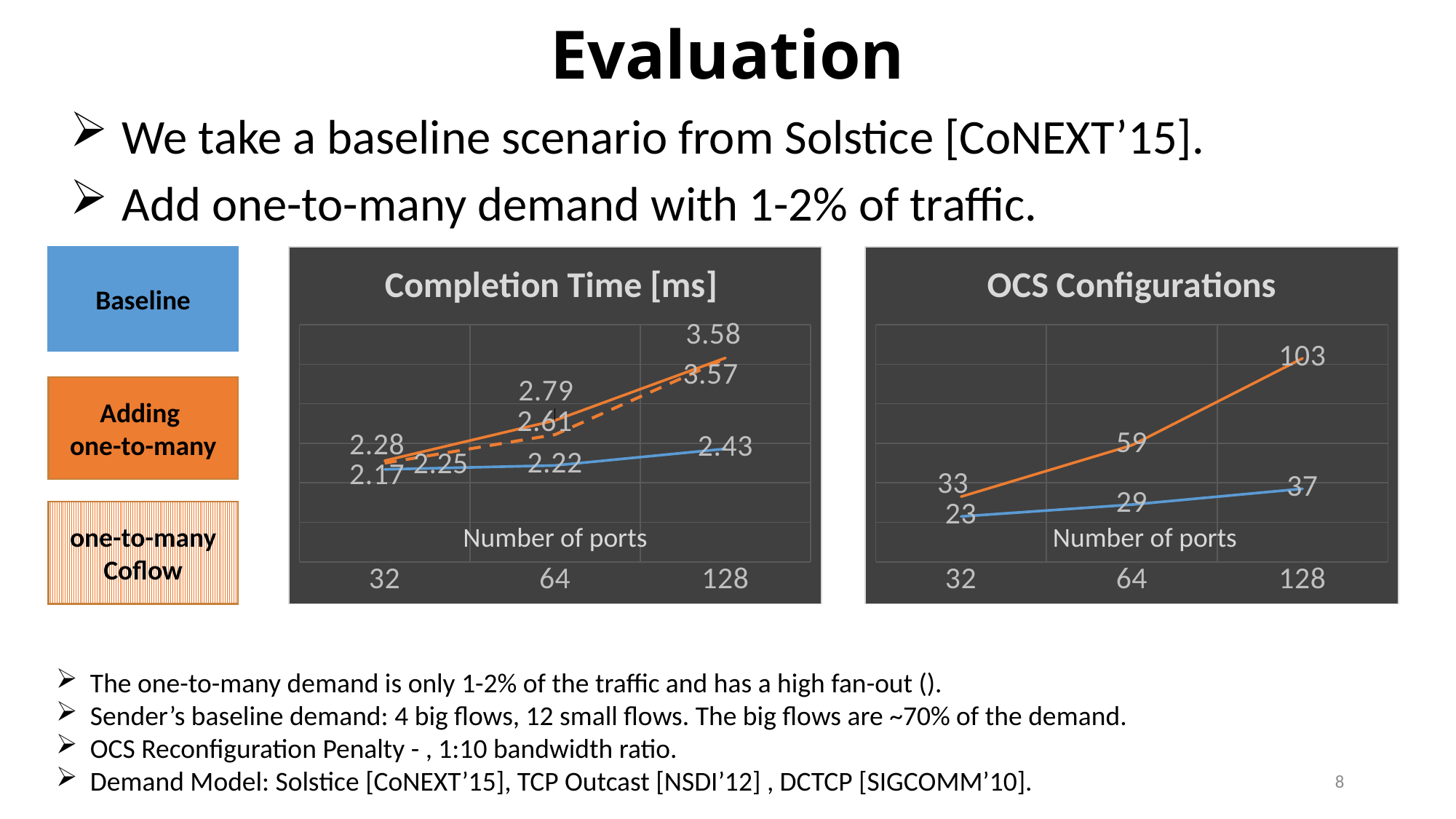
In the OCS Configurations chart, which series has the larger value at 64 ports, Baseline or Adding one-to-many? Adding one-to-many In the OCS Configurations chart, what is the Baseline value at 32 ports? 23 In the Completion Time [ms] chart, what is the difference between the Adding one-to-many and Baseline values at 128 ports? 1.15 In the Completion Time [ms] chart, what is the Baseline value at 32 ports? 2.17 In the OCS Configurations chart, what is the Adding one-to-many value at 128 ports? 103 In the Completion Time [ms] chart, what is the Baseline value at 128 ports? 2.43 What is the x-axis label of the Completion Time [ms] chart? Number of ports How many port counts are plotted on the x axis of the Completion Time [ms] chart? 3 In the OCS Configurations chart, does the Baseline series rise or fall as the number of ports increases? rises In the Completion Time [ms] chart, what is the Adding one-to-many value at 64 ports? 2.79 What kind of chart is the OCS Configurations chart? line chart In the OCS Configurations chart, what is the difference between the Adding one-to-many and Baseline values at 128 ports? 66